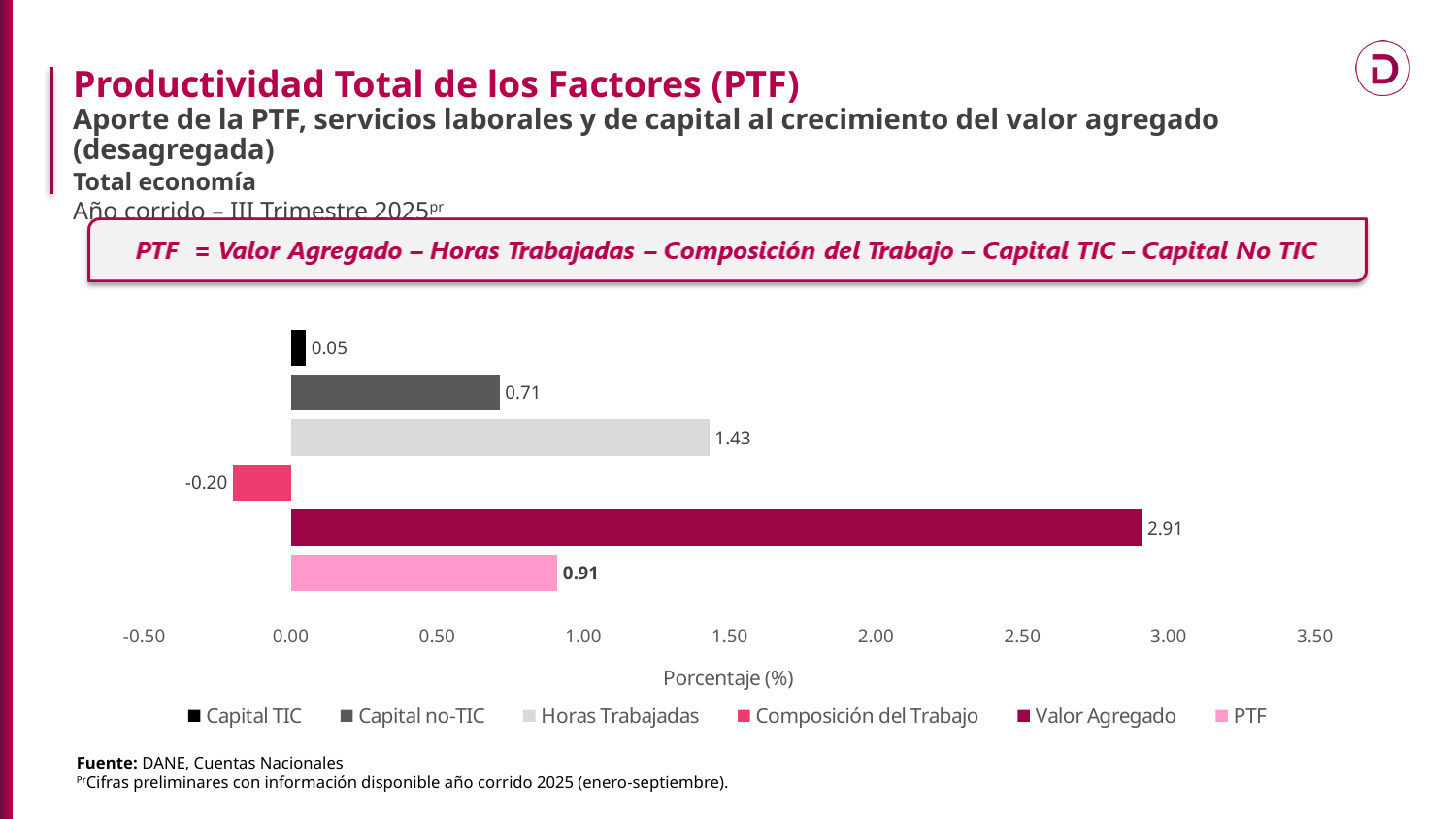
What kind of chart is shown on the slide? Bar chart Which is larger, the value for Capital no-TIC or the value for PTF? PTF How many series does the legend list? 6 Which series has the lowest value? Composición del Trabajo Which series has the highest value? Valor Agregado What is the label of the horizontal axis? Porcentaje (%) What is the value shown for Valor Agregado? 2.91 What is the difference between the values for Valor Agregado and Horas Trabajadas? 1.48 What is the value shown for Horas Trabajadas? 1.43 What is the value shown for Composición del Trabajo? -0.20 What is the value shown for PTF? 0.91 Is the value for Capital TIC greater or less than 0.50? less